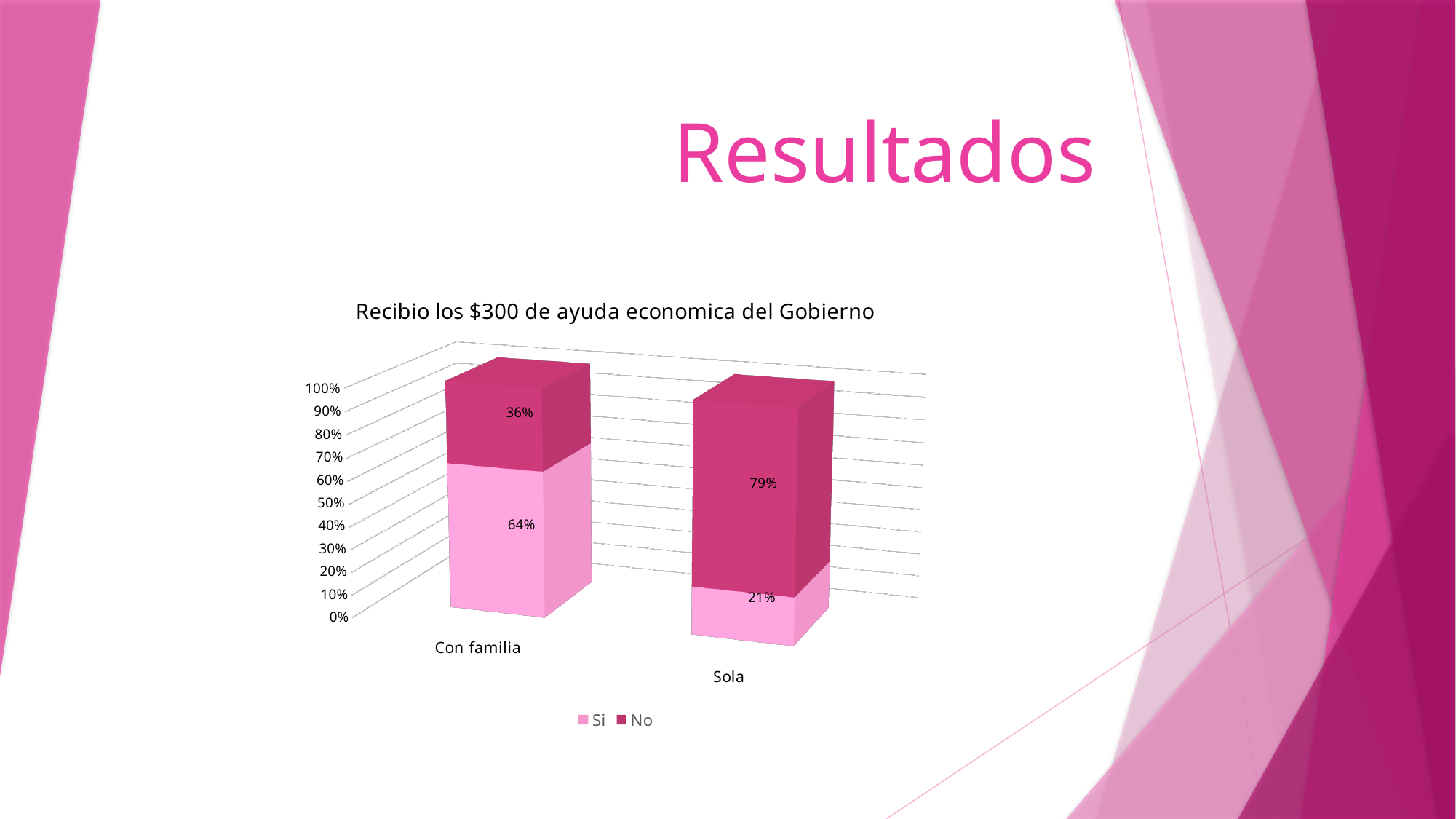
What is the title of the chart? Recibio los $300 de ayuda economica del Gobierno What kind of chart is shown on the slide? Stacked bar chart Which category has the highest value for "Si"? Con familia What is the value for "No" in the "Sola" category? 79% What is the value for "Si" in the "Sola" category? 21% How many categories are shown on the x axis? 2 Which category has the lowest value for "No"? Con familia What is the value for "No" in the "Con familia" category? 36% What is the value for "Si" in the "Con familia" category? 64% What is the difference between the "No" values for "Sola" and "Con familia"? 43% How many series does the legend list? 2 Which is larger: the "Si" value for "Con familia" or the "Si" value for "Sola"? Con familia